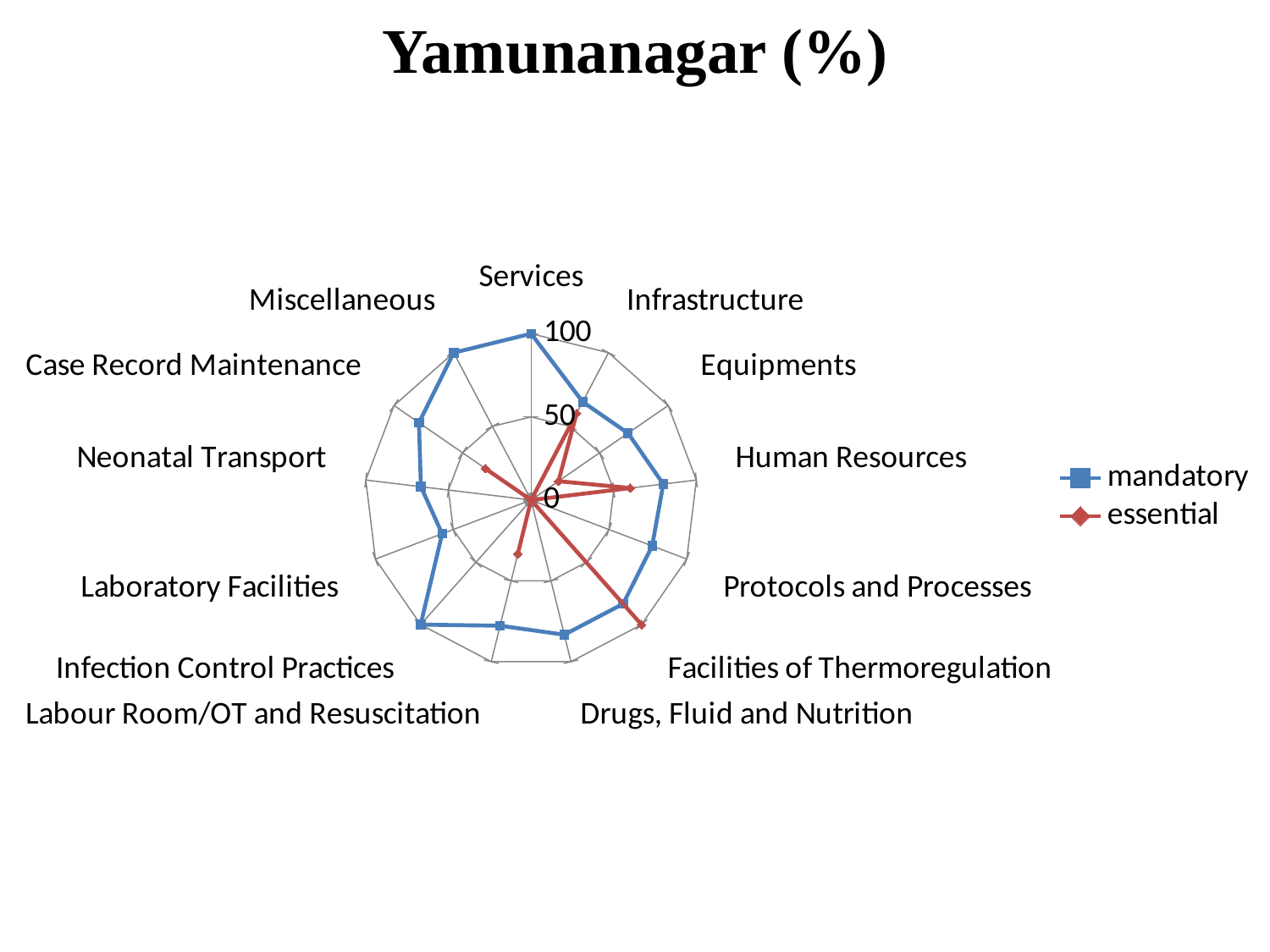
For Human Resources, which series has the larger value, mandatory or essential? mandatory Is the essential value for Infrastructure greater or less than 50? greater What kind of chart is shown on the slide? Radar chart What is the title of the chart? Yamunanagar (%) Is the mandatory value for Human Resources greater or less than 50? greater Which two series are listed in the legend? mandatory and essential Is the mandatory value for Services greater or less than 50? greater For the essential series, which is larger: Facilities of Thermoregulation or Laboratory Facilities? Facilities of Thermoregulation How many categories are plotted around the radar chart? 13 How many series does the legend list? 2 Which category has the highest essential value? Facilities of Thermoregulation